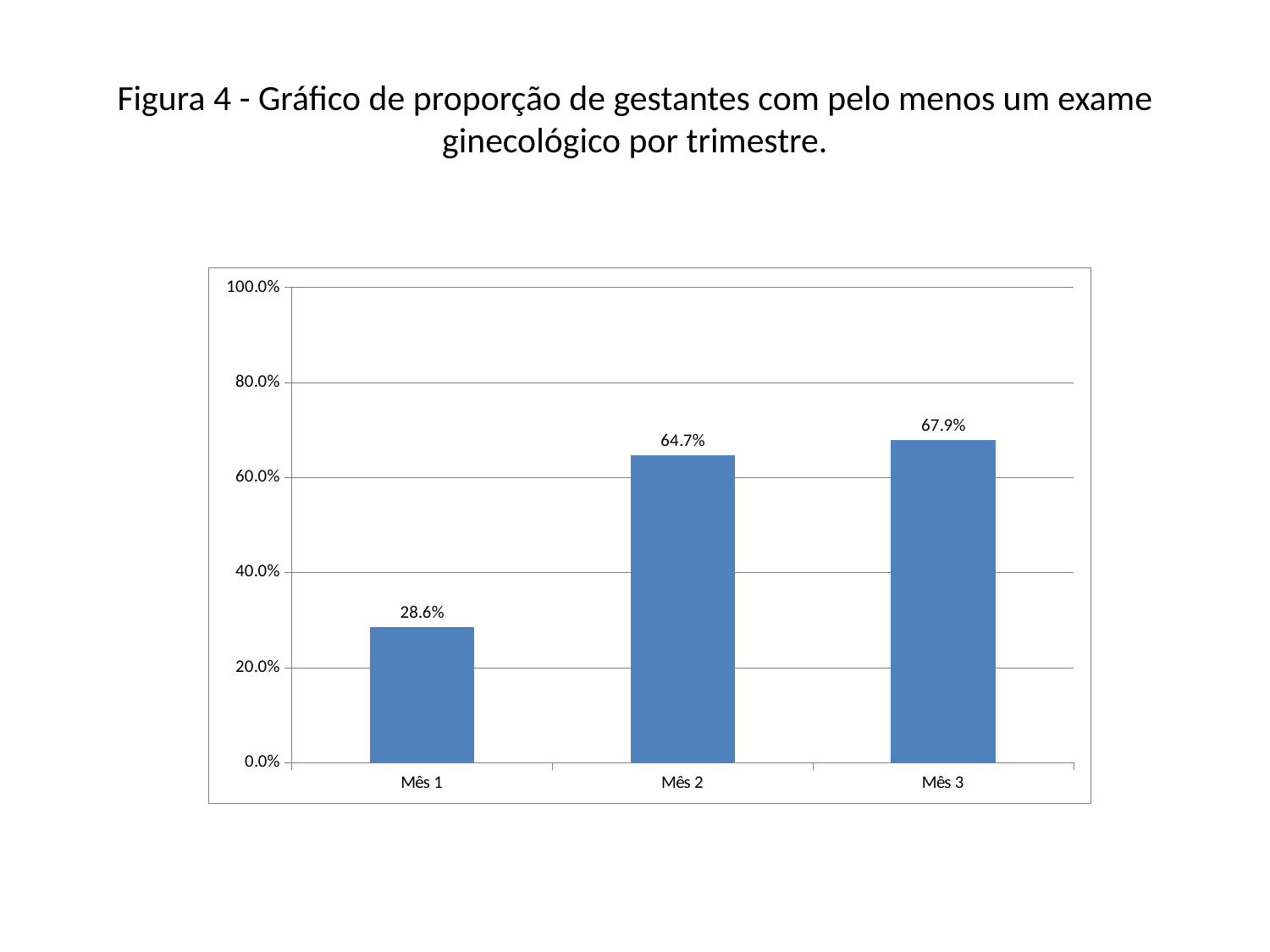
What kind of chart is shown on the slide? bar chart What is the difference between the values for Mês 3 and Mês 2? 3.2% Is the value for Mês 1 greater or less than 40.0%? less What is the value for Mês 3? 67.9% Which month has the highest value? Mês 3 How many categories are shown on the x axis? 3 What is the value for Mês 1? 28.6% What is the value for Mês 2? 64.7% Which month has the lowest value? Mês 1 Which is larger, the value for Mês 1 or the value for Mês 2? Mês 2 What is the difference between the values for Mês 2 and Mês 1? 36.1% Do the values rise or fall from Mês 1 to Mês 3? rise